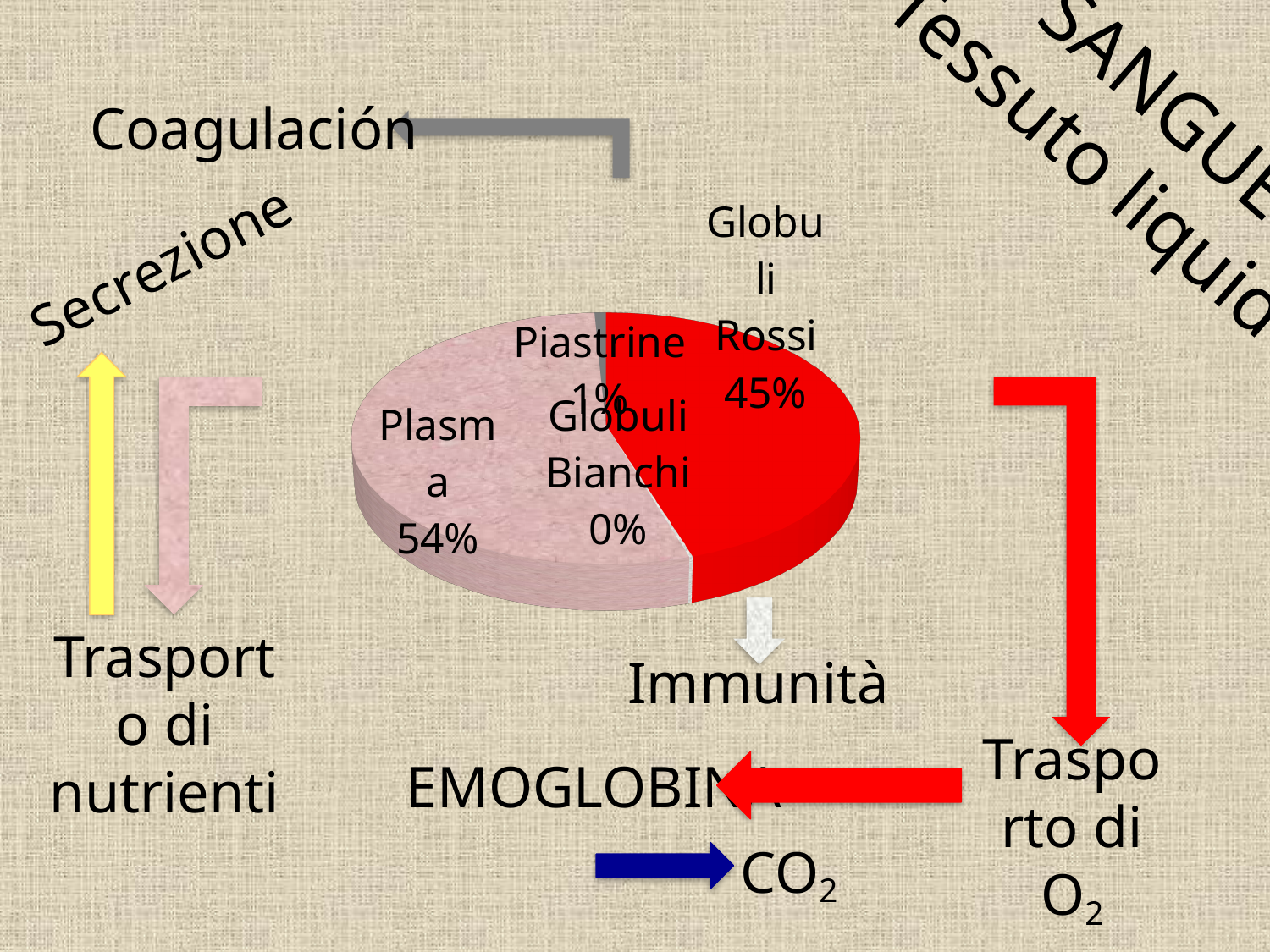
What is the combined percentage of Piastrine and Globuli Bianchi in the pie chart? 1% What percentage of the pie chart is Globuli Rossi? 45% Which slice of the pie chart is the smallest? Globuli Bianchi How many slices are labelled in the pie chart? 4 What kind of chart is shown on the slide? pie chart What colour is the Globuli Rossi slice of the pie chart? red What percentage of the pie chart is Plasma? 54% What percentage of the pie chart is Piastrine? 1% What percentage of the pie chart is Globuli Bianchi? 0% What is the difference in percentage points between Plasma and Globuli Rossi? 9 Which is larger in the pie chart, Plasma or Globuli Rossi? Plasma Which slice of the pie chart is the largest? Plasma